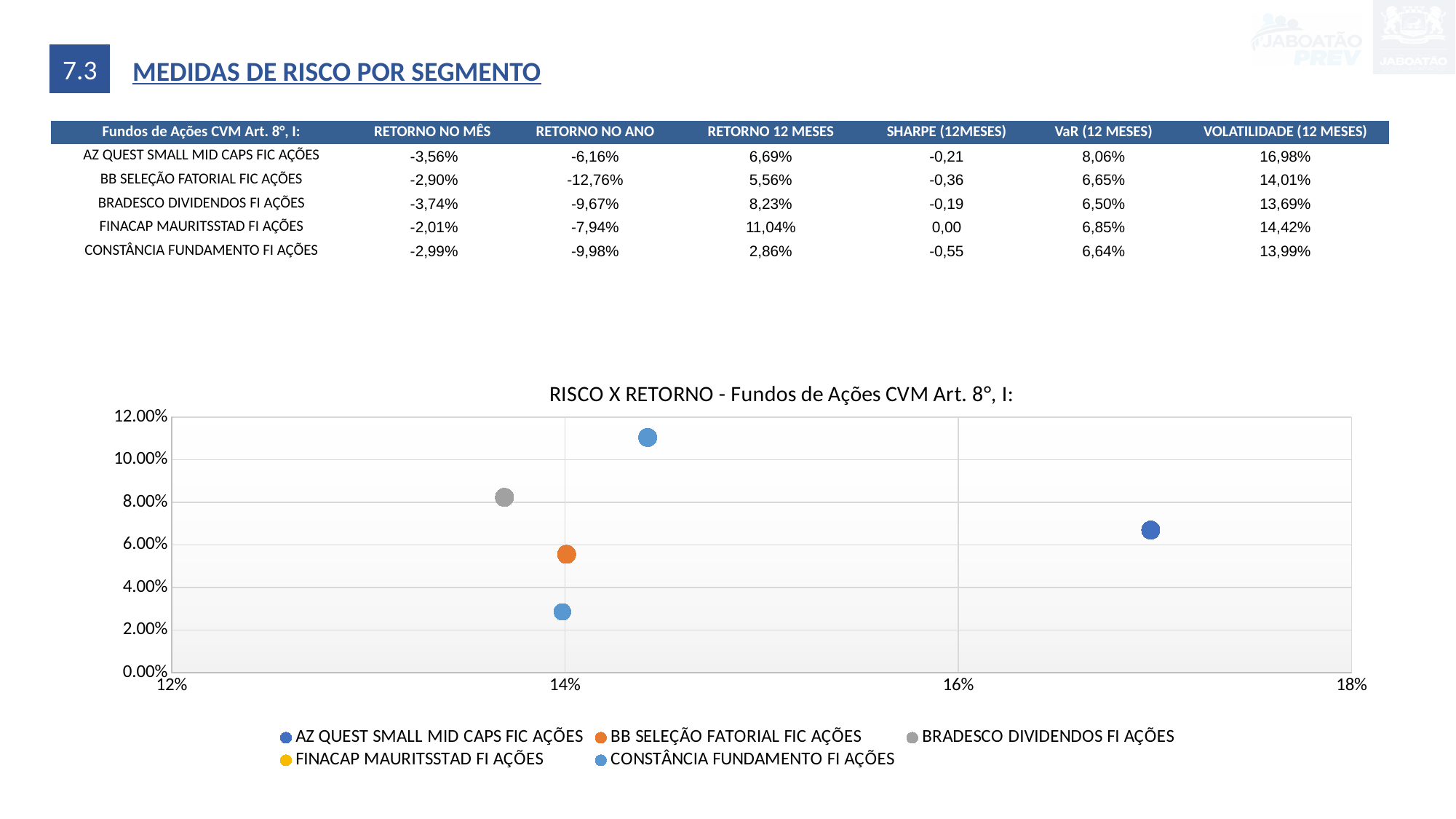
In the RISCO X RETORNO chart, which fund is plotted further to the right: AZ QUEST SMALL MID CAPS FIC AÇÕES or BB SELEÇÃO FATORIAL FIC AÇÕES? AZ QUEST SMALL MID CAPS FIC AÇÕES In the RISCO X RETORNO chart, which point is higher on the vertical axis: the gray point (BRADESCO DIVIDENDOS FI AÇÕES) or the orange point (BB SELEÇÃO FATORIAL FIC AÇÕES)? BRADESCO DIVIDENDOS FI AÇÕES How many data points are plotted in the RISCO X RETORNO chart? 5 What kind of chart is shown under the title 'RISCO X RETORNO - Fundos de Ações CVM Art. 8°, I:'? Scatter chart In the RISCO X RETORNO chart, is the vertical value of the orange point (BB SELEÇÃO FATORIAL FIC AÇÕES) greater or less than 6.00%? less In the RISCO X RETORNO chart, which fund has the lowest point on the vertical axis (lowest 12-month return)? CONSTÂNCIA FUNDAMENTO FI AÇÕES What is the title of the scatter chart on the slide? RISCO X RETORNO - Fundos de Ações CVM Art. 8°, I: In the RISCO X RETORNO chart, is the vertical value of the highest point greater or less than 10.00%? greater How many series does the legend of the RISCO X RETORNO chart list? 5 In the RISCO X RETORNO chart, is the vertical value of the rightmost point (AZ QUEST SMALL MID CAPS FIC AÇÕES) greater or less than 6.00%? greater What is the range of the horizontal axis in the RISCO X RETORNO chart? 12% to 18% In the RISCO X RETORNO chart, which fund is plotted furthest to the right (highest volatility)? AZ QUEST SMALL MID CAPS FIC AÇÕES